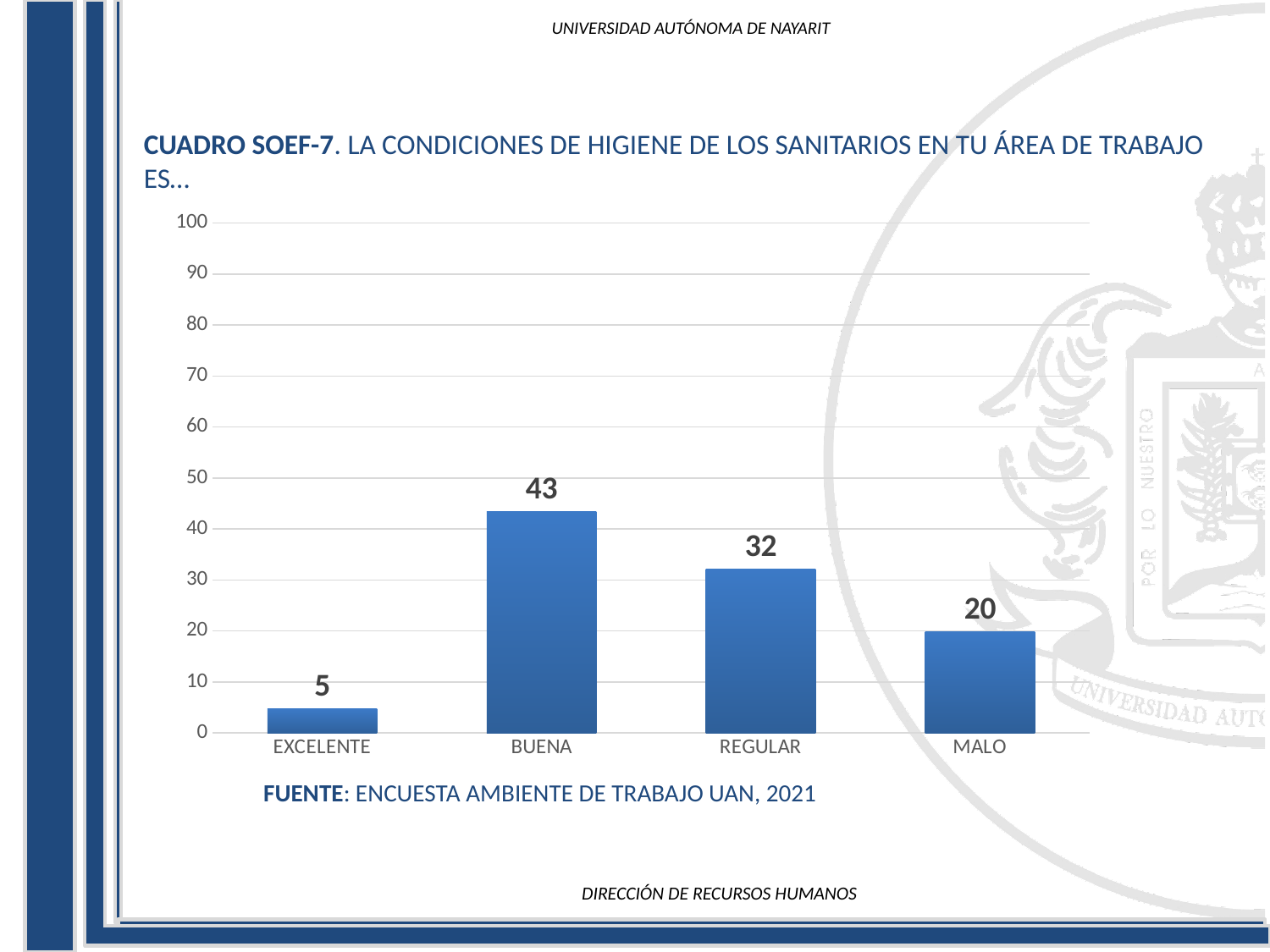
What is the difference between the values for BUENA and REGULAR? 11 Which category has the lowest value? EXCELENTE Is the value for REGULAR greater or less than 30? greater Which is larger, the value for REGULAR or the value for MALO? REGULAR What is the value for EXCELENTE? 5 Which category has the highest value? BUENA What is the value for MALO? 20 What is the total of the values for EXCELENTE and MALO? 25 What is the value for BUENA? 43 What kind of chart is shown on the slide? Bar chart What source is cited below the chart? ENCUESTA AMBIENTE DE TRABAJO UAN, 2021 How many categories are shown on the x axis? 4